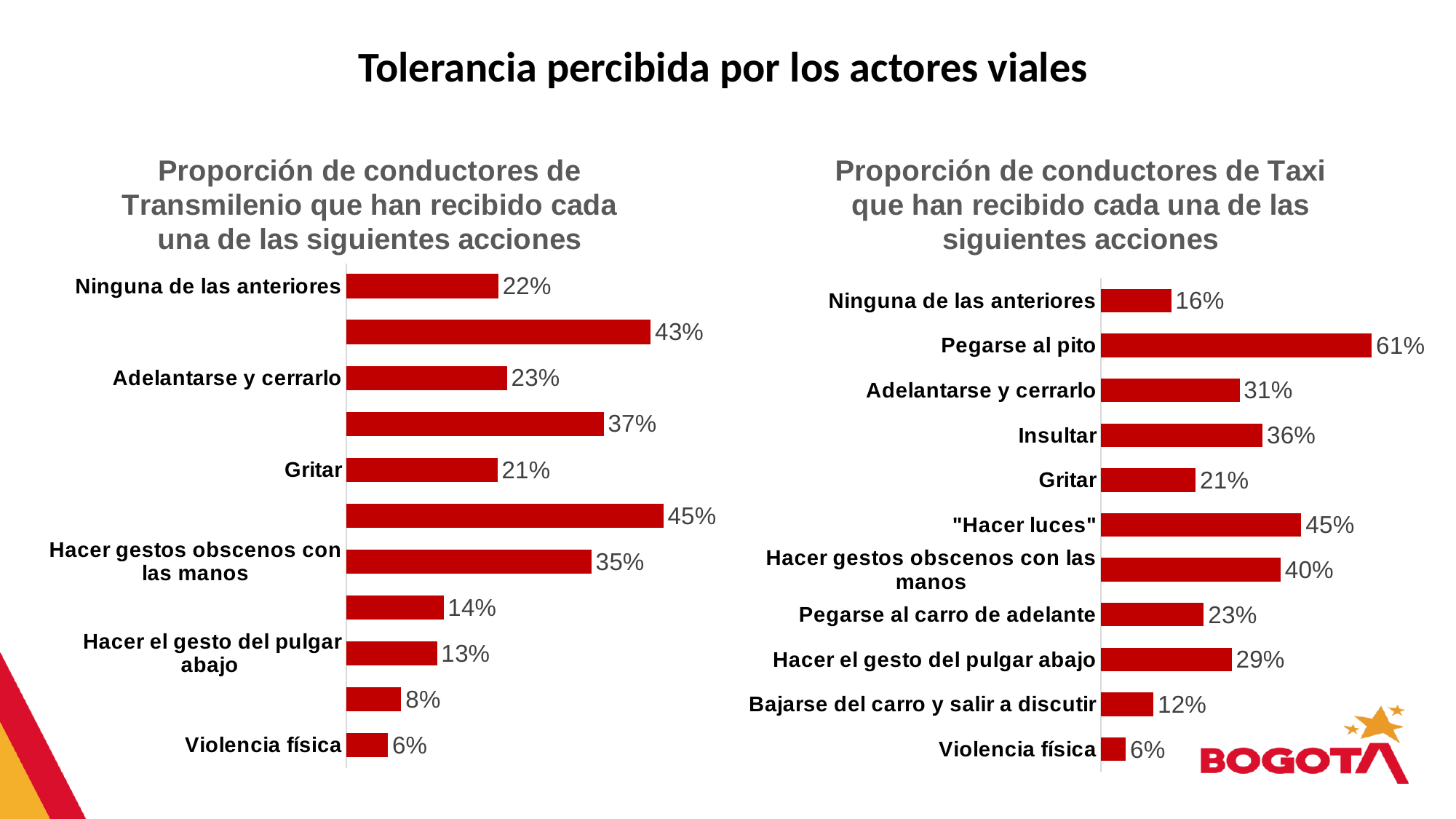
In the Taxi chart on the right, what is the value for "Hacer luces"? 45% In the Transmilenio chart on the left, what is the value for "Gritar"? 21% Which is larger: "Adelantarse y cerrarlo" in the Transmilenio chart or "Adelantarse y cerrarlo" in the Taxi chart? Taxi chart What is the main title of the slide? Tolerancia percibida por los actores viales In the Transmilenio chart on the left, what is the value for "Hacer gestos obscenos con las manos"? 35% In the Transmilenio chart on the left, what is the difference between "Adelantarse y cerrarlo" and "Violencia física"? 17% In the Taxi chart on the right, which action has the lowest proportion? Violencia física What type of chart is used in the Taxi chart on the right? Bar chart In the Taxi chart on the right, what is the difference between "Insultar" and "Gritar"? 15% In the Taxi chart on the right, how many actions (bars) are shown? 11 In the Taxi chart on the right, what proportion of taxi drivers have received "Pegarse al pito"? 61% In the Taxi chart on the right, which action has the highest proportion? Pegarse al pito